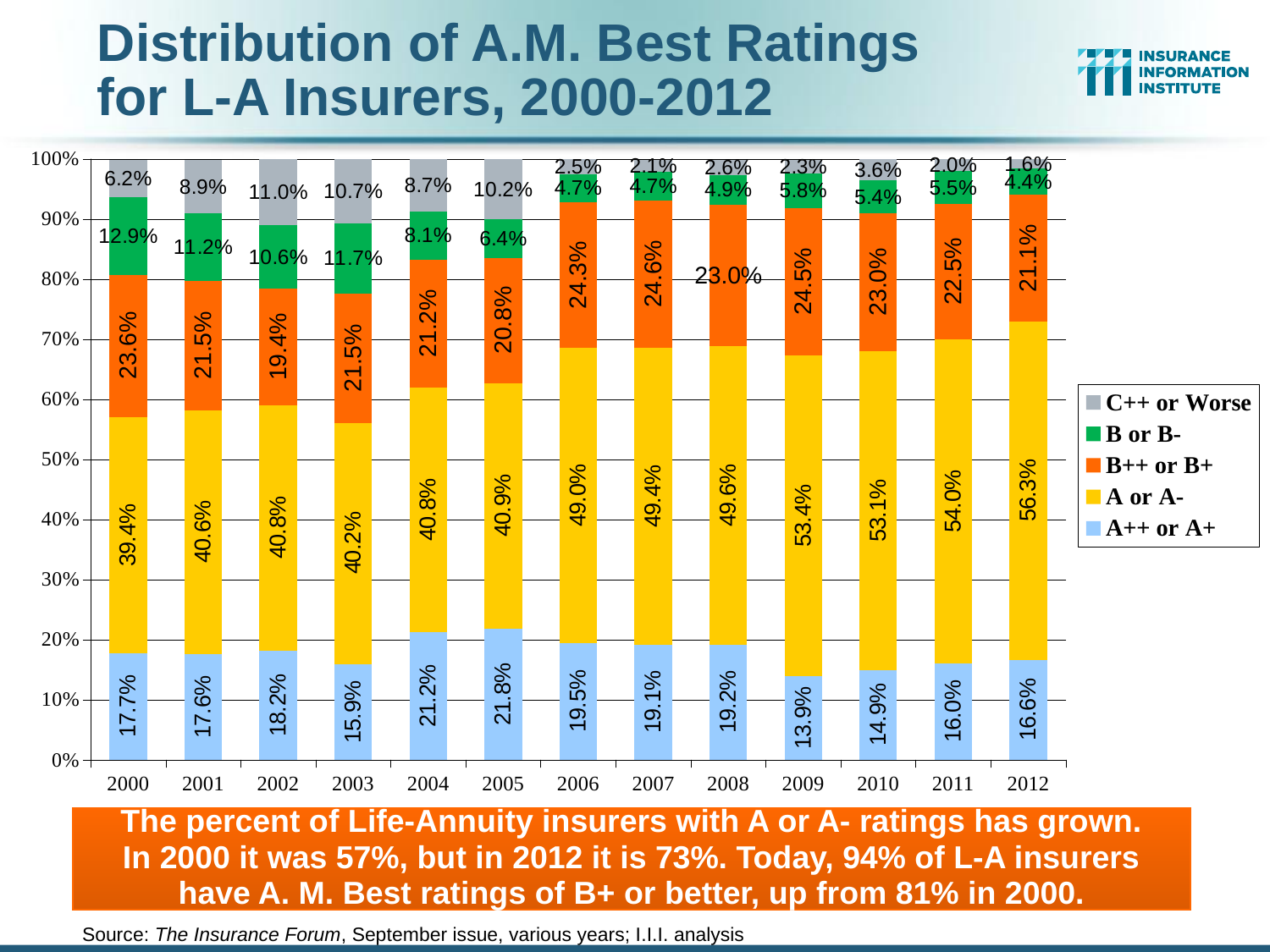
What was the share of insurers rated B++ or B+ in 2007? 24.6% How much larger was the A or A- share in 2012 than in 2000? 16.9 percentage points Does the A or A- share generally rise or fall from 2000 to 2012? Rise Which year had a larger C++ or Worse share, 2001 or 2010? 2001 What percentage of L-A insurers had an A or A- rating in 2012? 56.3% How many rating categories does the legend list? 5 In which year was the A++ or A+ share the lowest? 2009 What was the share of insurers rated C++ or Worse in 2002? 11.0% How many years are shown on the x axis? 13 What type of chart is shown on the slide? Stacked bar chart What percentage of L-A insurers had an A++ or A+ rating in 2005? 21.8% In which year was the A or A- share the highest? 2012